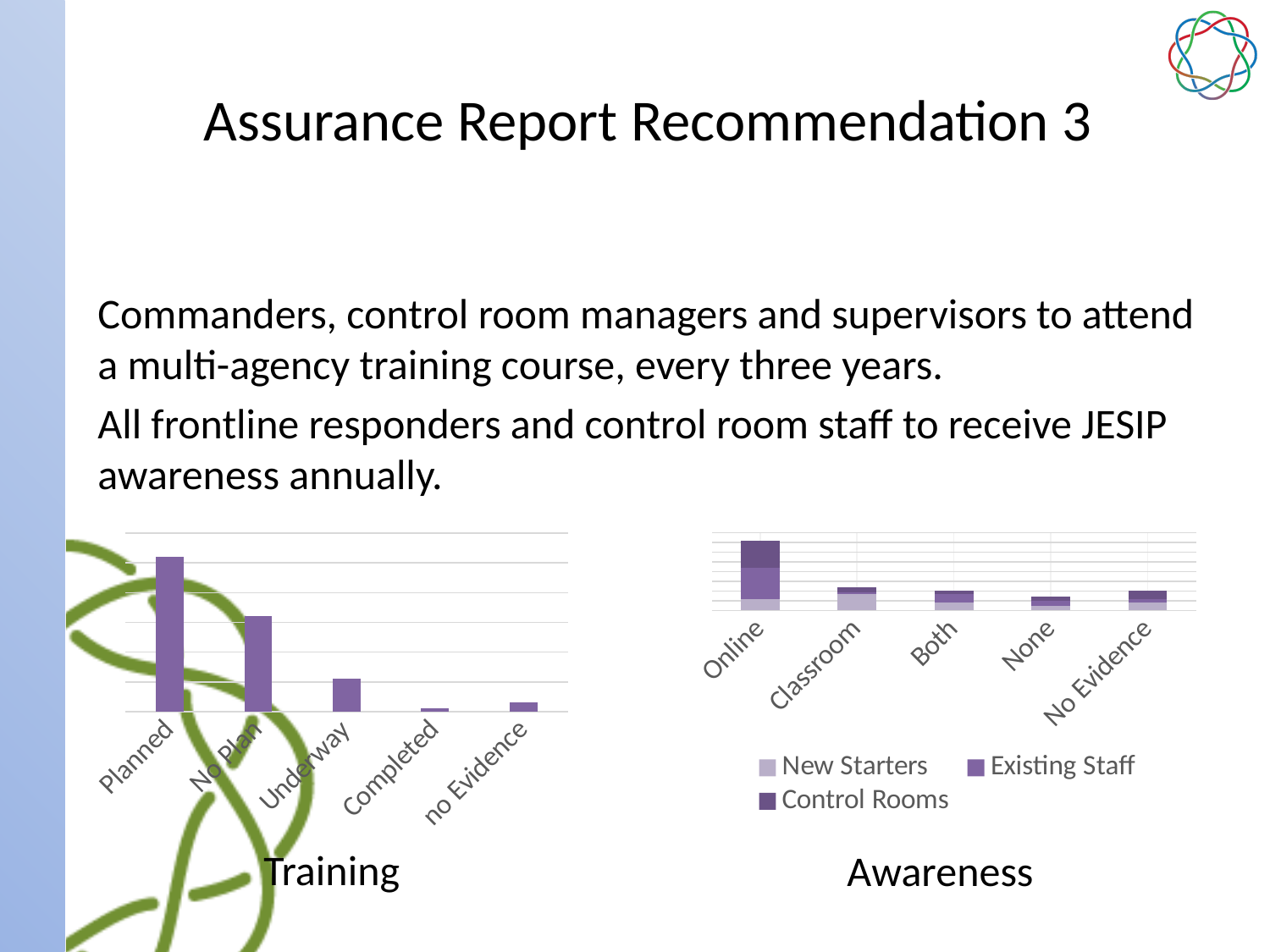
On the Awareness chart, which category has the tallest stacked bar? Online On the Training chart, which is larger, the bar for Planned or the bar for No Plan? Planned On the Awareness chart, which category has the shortest stacked bar? None On the Training chart, which category has the lowest bar? Completed On the Awareness chart, how many categories are shown on the x axis? 5 On the Awareness chart, which is larger, the stacked bar for Online or the stacked bar for Classroom? Online On the Awareness chart, what are the three series named in the legend? New Starters, Existing Staff, Control Rooms On the Training chart, which is larger, the bar for Underway or the bar for no Evidence? Underway What kind of chart is the Training chart? Bar chart On the Awareness chart, how many series does the legend list? 3 On the Training chart, which category has the highest bar? Planned On the Training chart, how many categories are shown on the x axis? 5